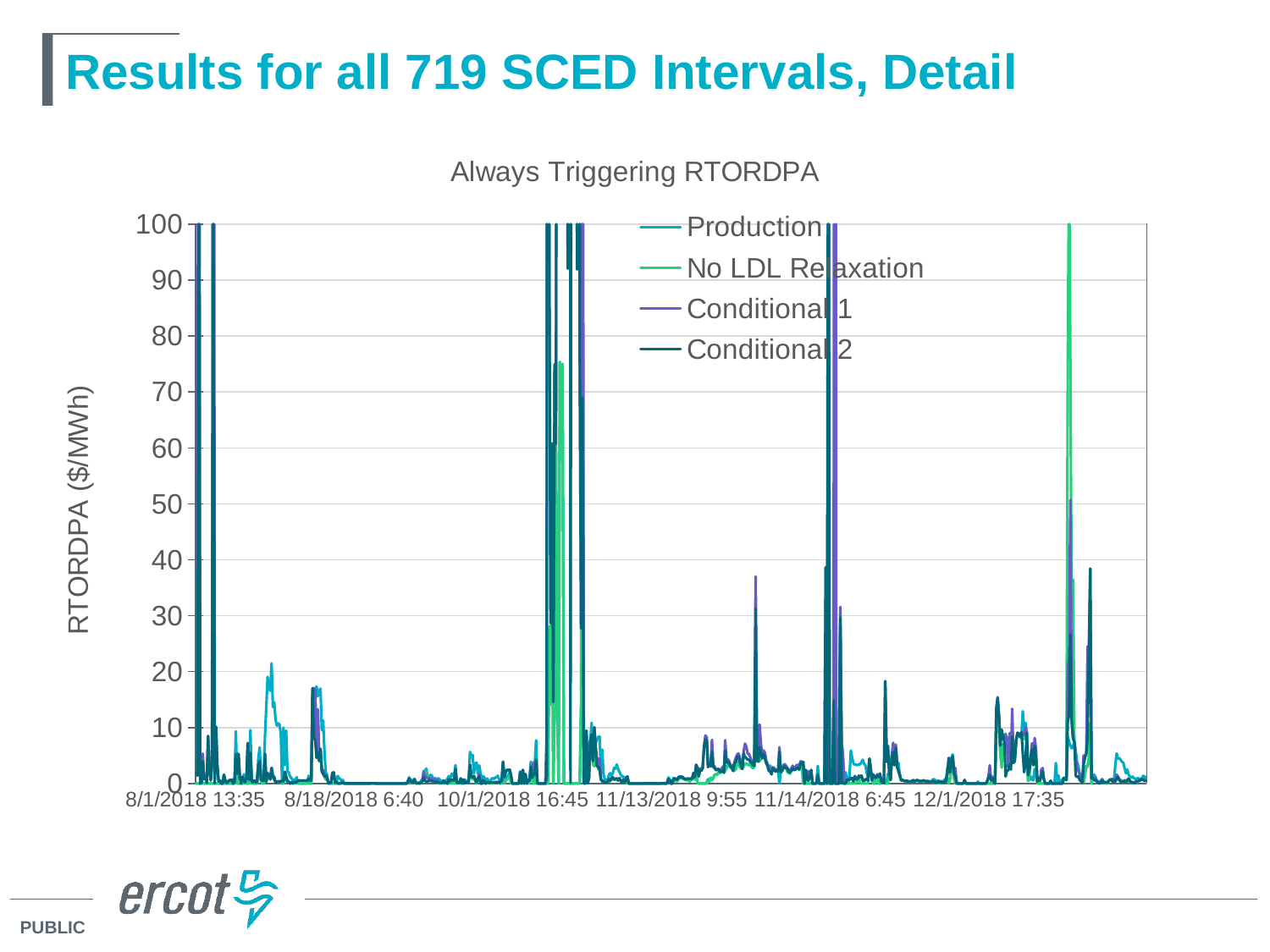
What is the title of the chart? Always Triggering RTORDPA What is the label of the chart's vertical axis? RTORDPA ($/MWh) Is the Conditional 1 spike between 11/13/2018 9:55 and 11/14/2018 6:45 greater or less than 50? less What kind of chart is shown on the slide? line chart What is the highest value shown on the chart's vertical axis? 100 How many date labels are shown along the chart's horizontal axis? 6 Is the highest value reached by the No LDL Relaxation series greater or less than 90? greater What is the first date label on the chart's horizontal axis? 8/1/2018 13:35 What is the lowest value shown on the chart's vertical axis? 0 What is the last date label on the chart's horizontal axis? 12/1/2018 17:35 How many series does the chart's legend list? 4 Is the peak of the Production series near 8/18/2018 6:40 greater or less than 50? less